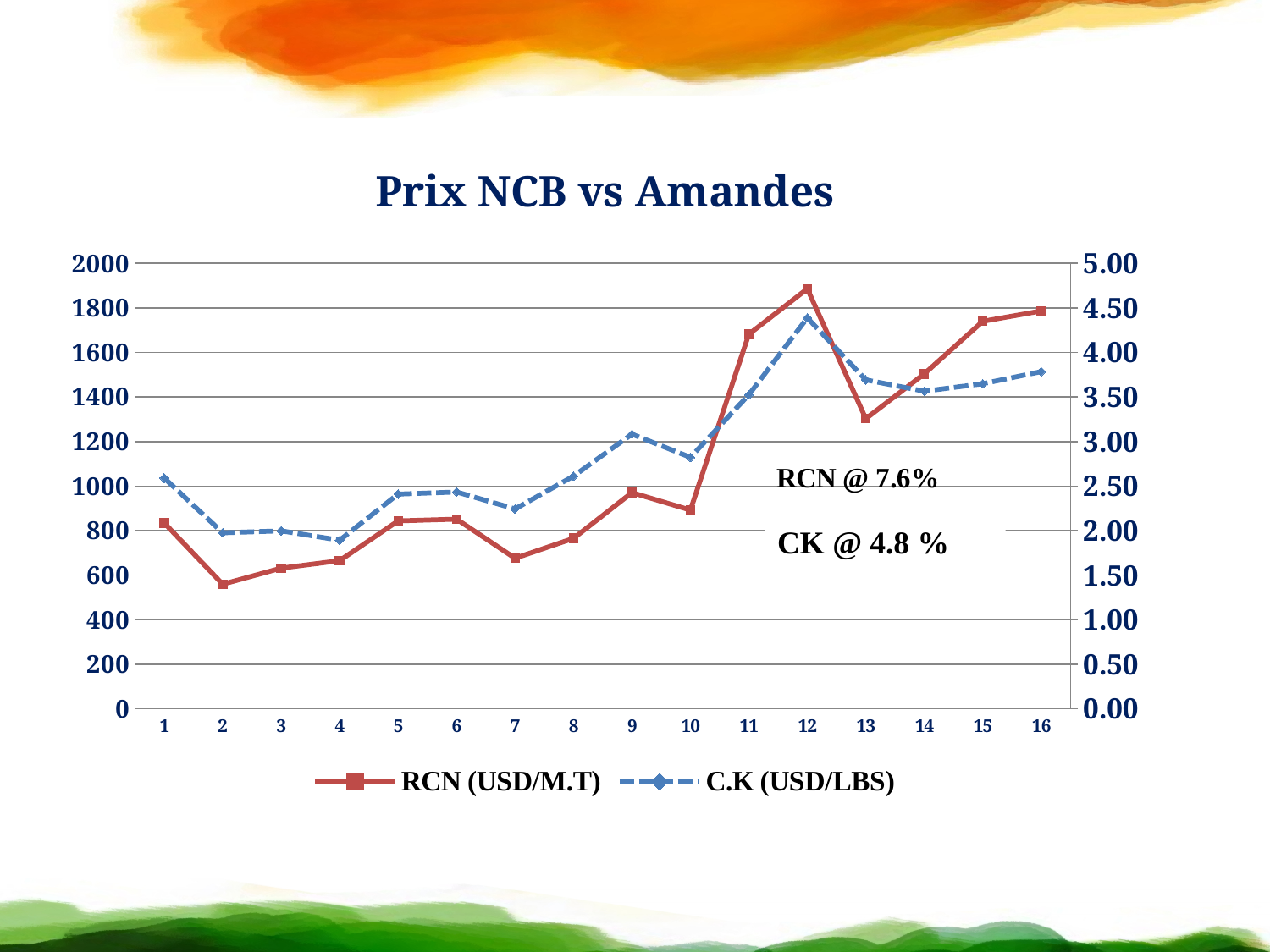
Does the RCN (USD/M.T) series rise or fall from point 10 to point 12? rise At which x-axis point does the RCN (USD/M.T) series reach its highest value? 12 At which x-axis point does the C.K (USD/LBS) series reach its highest value? 12 What is the title of the chart? Prix NCB vs Amandes At which x-axis point does the RCN (USD/M.T) series reach its lowest value? 2 What kind of chart is shown on the slide? line chart How many points are plotted along the x axis for each series? 16 Which is larger for the RCN (USD/M.T) series: the value at point 12 or the value at point 13? point 12 Is the RCN (USD/M.T) value at point 2 greater or less than 600? less Is the C.K (USD/LBS) value at point 16 greater or less than 3.50? greater How many series does the legend list? 2 Is the RCN (USD/M.T) value at point 12 greater or less than 1800? greater